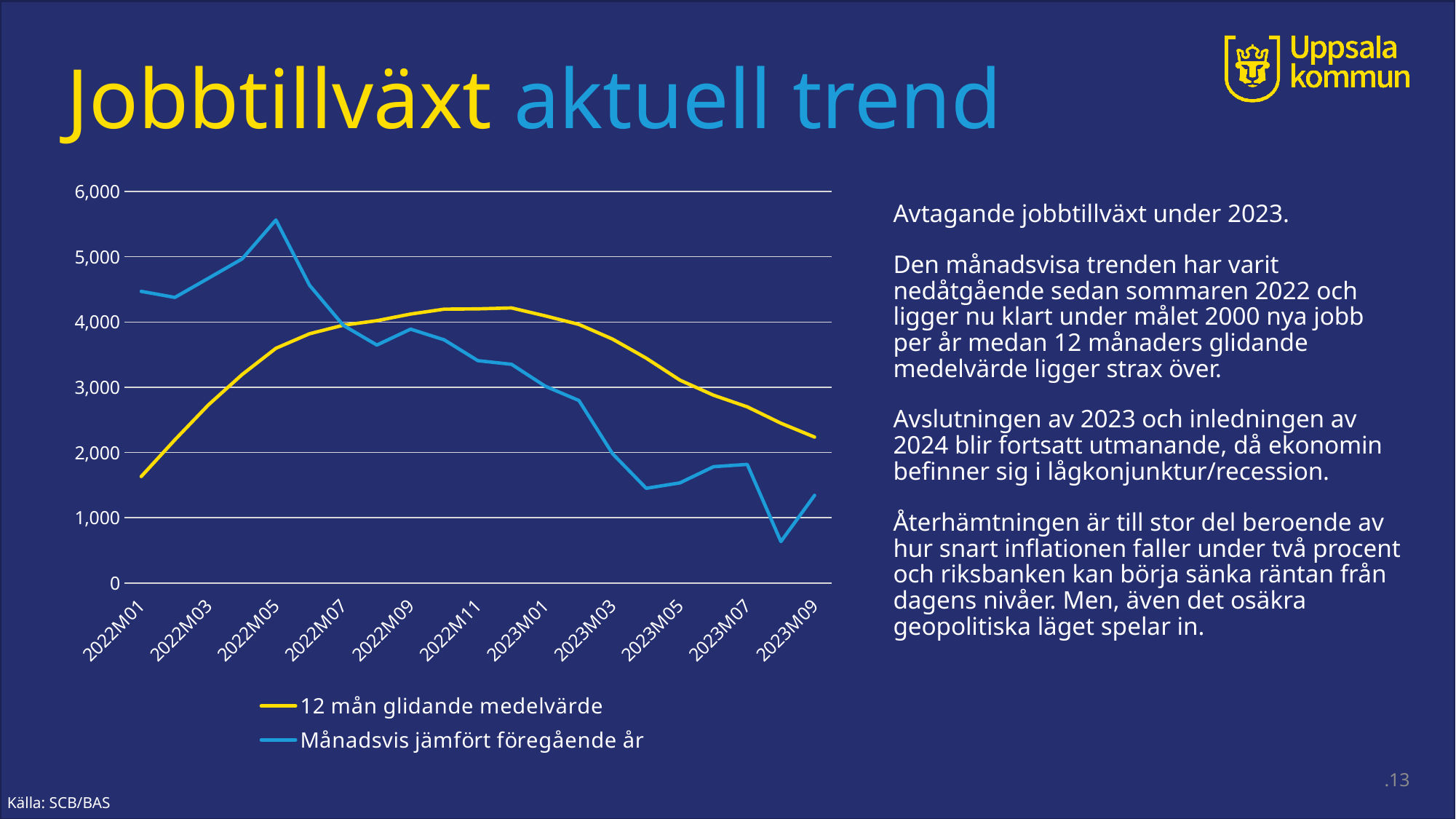
Is the value of '12 mån glidande medelvärde' at 2022M01 greater or less than 2,000? less Is the value of 'Månadsvis jämfört föregående år' at 2022M05 greater or less than 5,000? greater How many series does the legend list? 2 At 2023M09, which series has the higher value, '12 mån glidande medelvärde' or 'Månadsvis jämfört föregående år'? 12 mån glidande medelvärde Which series is drawn in blue? Månadsvis jämfört föregående år Does 'Månadsvis jämfört föregående år' rise or fall overall from 2022M05 to 2023M09? fall Which series is drawn in yellow? 12 mån glidande medelvärde What kind of chart is shown on the slide? line chart Is the value of '12 mån glidande medelvärde' at 2023M09 greater or less than 2,000? greater At which labelled month does 'Månadsvis jämfört föregående år' reach its highest value? 2022M05 At 2022M01, which series has the higher value, '12 mån glidande medelvärde' or 'Månadsvis jämfört föregående år'? Månadsvis jämfört föregående år